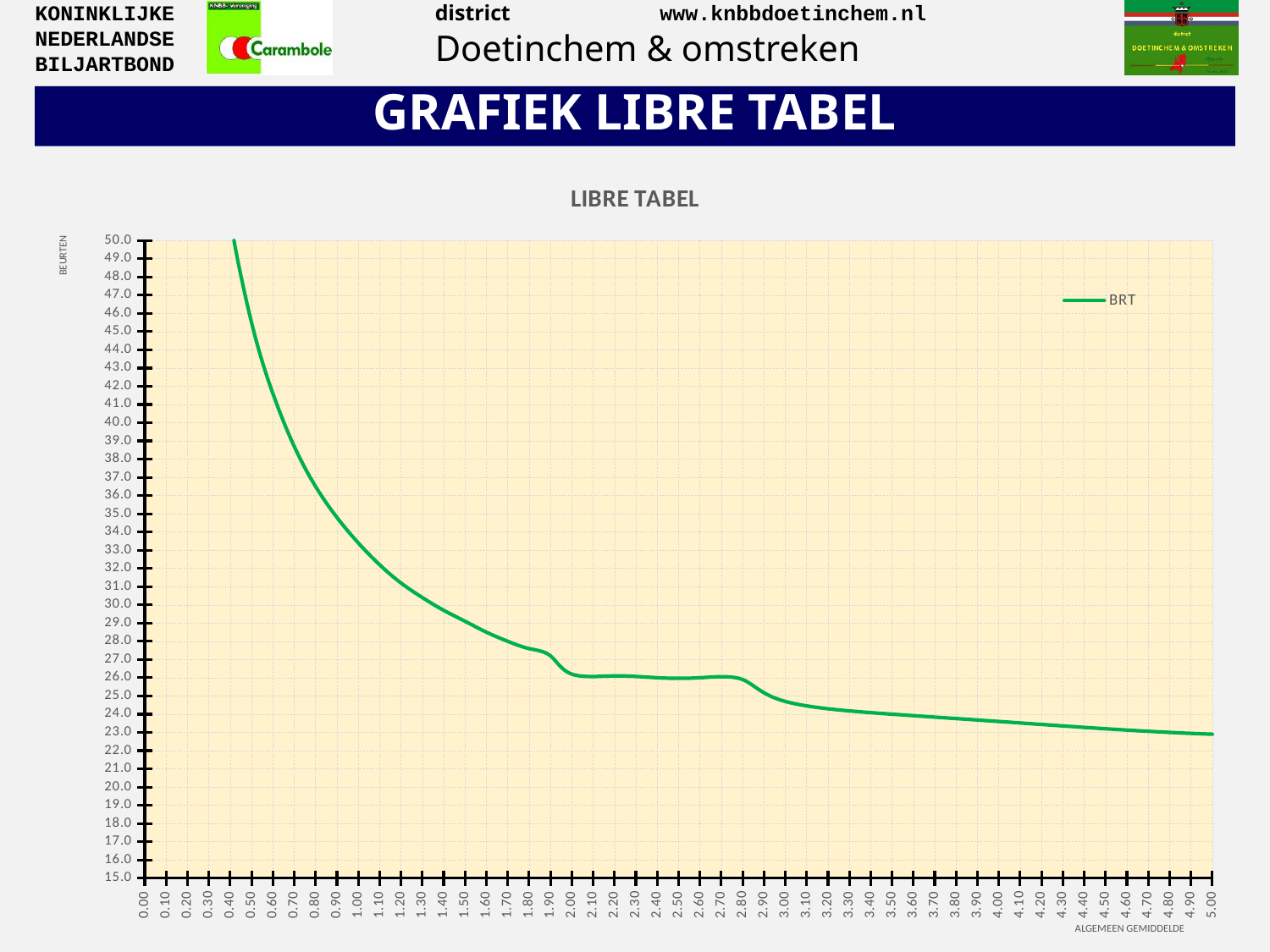
What is the name of the series shown in the legend? BRT Is the BRT value at an ALGEMEEN GEMIDDELDE of 2.00 greater or less than 30.0? less Is the BRT value at an ALGEMEEN GEMIDDELDE of 1.00 greater or less than 30.0? greater What kind of chart is shown on the slide? line chart Do the BRT values rise or fall as ALGEMEEN GEMIDDELDE increases along the x axis? fall How many series does the legend list? 1 What is the title of the chart? LIBRE TABEL Is the BRT value at an ALGEMEEN GEMIDDELDE of 4.00 greater or less than 25.0? less What is the highest value shown on the y axis (BEURTEN)? 50.0 Which is larger, the BRT value at an ALGEMEEN GEMIDDELDE of 1.50 or at 3.00? 1.50